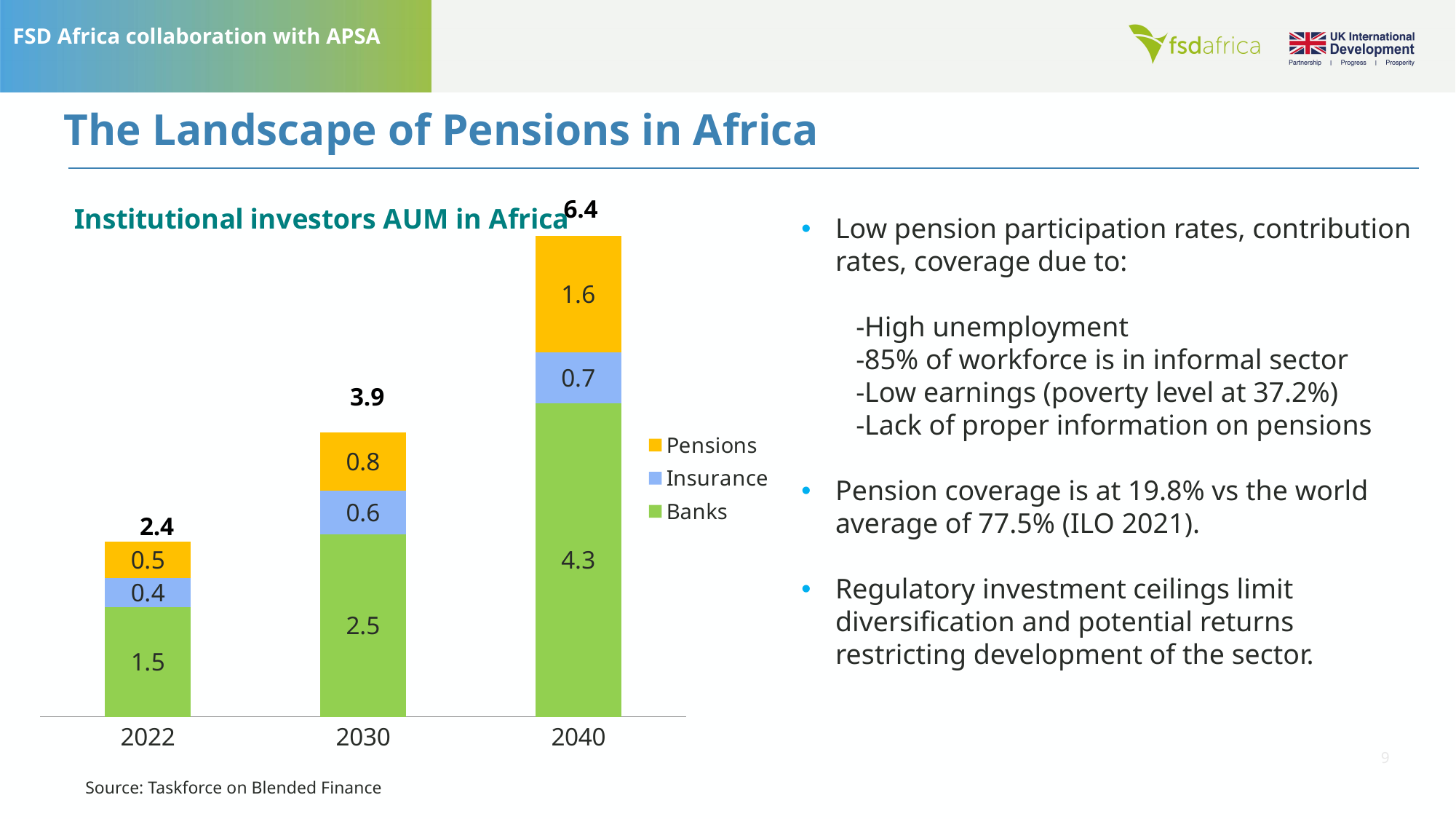
How many series does the legend list? 3 What is the value for Pensions in 2030? 0.8 Which year has the lowest total institutional investors AUM? 2022 What is the value for Insurance in 2022? 0.4 Do the total AUM values rise or fall from 2022 to 2040? Rise What is the difference between the Pensions value in 2040 and the Pensions value in 2022? 1.1 Which is larger in 2030: the Insurance value or the Pensions value? Pensions Which year has the highest total institutional investors AUM? 2040 What is the total AUM shown above the 2030 bar? 3.9 What is the value for Banks in 2040 in the Institutional investors AUM in Africa chart? 4.3 What is the total AUM shown above the 2040 bar? 6.4 What kind of chart is used to show Institutional investors AUM in Africa? Stacked bar chart